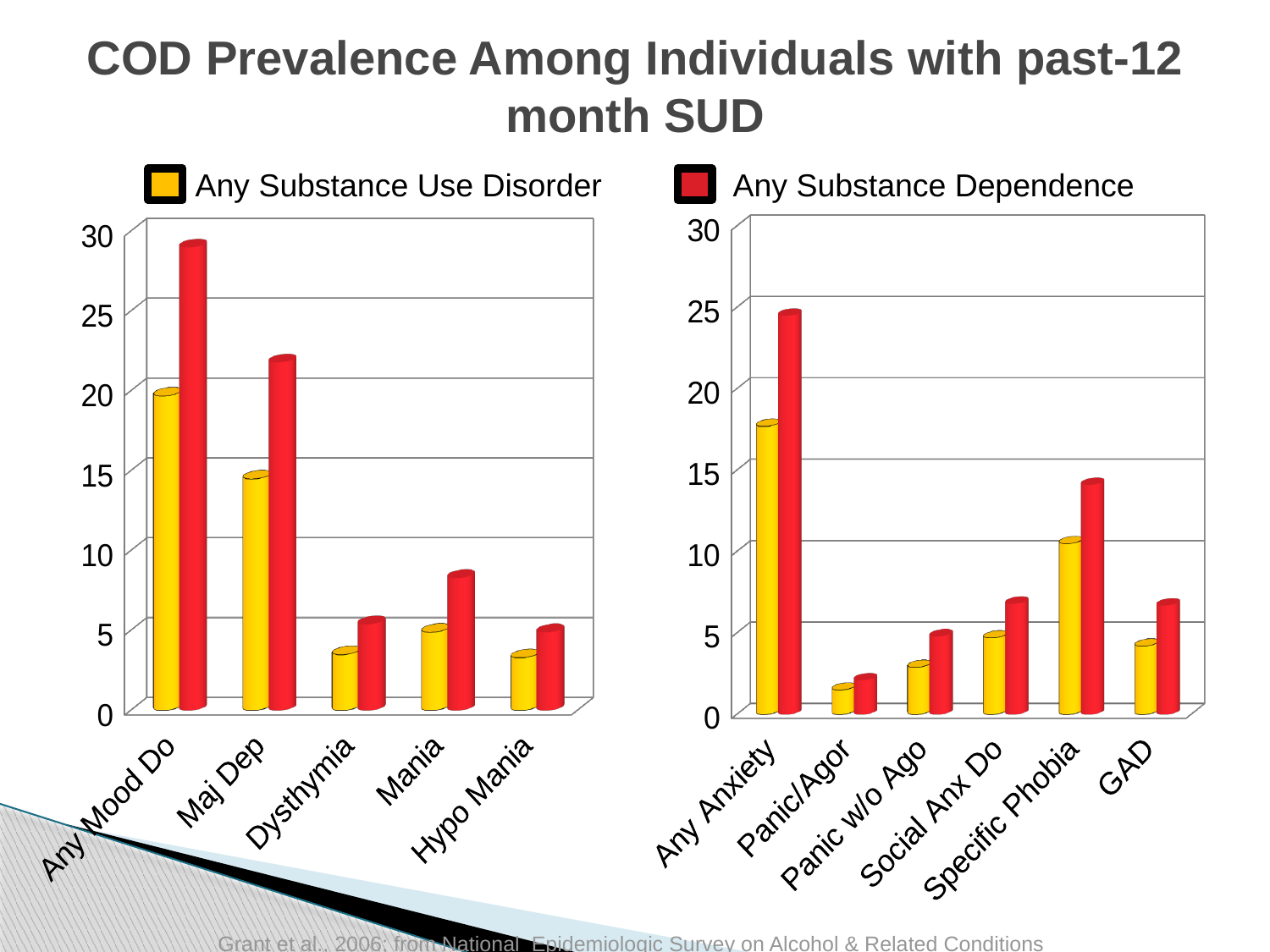
In the right chart, which category has the lowest Any Substance Dependence value? Panic/Agor In the right chart (anxiety disorders), how many categories are shown on the x axis? 6 In the left chart, is the Any Substance Dependence value for Any Mood Do greater or less than 25? greater In the left chart, which category has the highest Any Substance Dependence value? Any Mood Do In the left chart, is the Any Substance Dependence value for Maj Dep greater or less than 20? greater Which colour represents Any Substance Dependence in the legend? Red What type of chart is used on this slide? Bar chart In the right chart, is the Any Substance Use Disorder value for Any Anxiety greater or less than 20? less How many series does the legend list? 2 In the right chart, which category has the highest Any Substance Use Disorder value? Any Anxiety In the left chart (mood disorders), how many categories are shown on the x axis? 5 In the right chart, which is larger for Any Substance Dependence: Specific Phobia or GAD? Specific Phobia